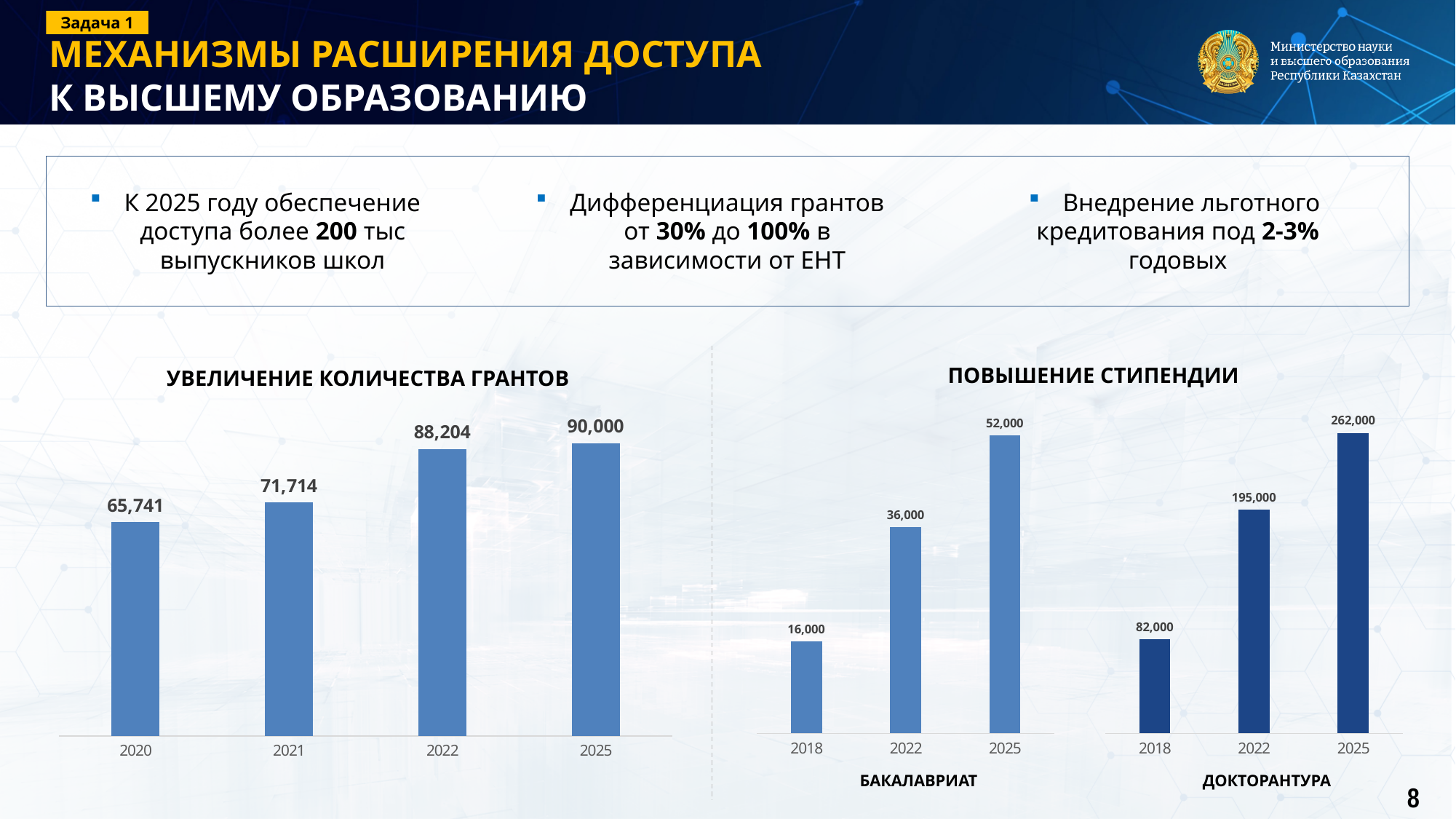
In the 'ПОВЫШЕНИЕ СТИПЕНДИИ' chart, what is the difference between the БАКАЛАВРИАТ values for 2025 and 2018? 36,000 In the chart titled 'УВЕЛИЧЕНИЕ КОЛИЧЕСТВА ГРАНТОВ', which year has the lowest value? 2020 In the chart titled 'УВЕЛИЧЕНИЕ КОЛИЧЕСТВА ГРАНТОВ', what is the value for 2021? 71,714 In the 'ПОВЫШЕНИЕ СТИПЕНДИИ' chart, which is larger: the ДОКТОРАНТУРА value for 2022 or the БАКАЛАВРИАТ value for 2025? ДОКТОРАНТУРА 2022 In the chart titled 'УВЕЛИЧЕНИЕ КОЛИЧЕСТВА ГРАНТОВ', do the values rise or fall from 2020 to 2025? rise What kind of chart is the one titled 'УВЕЛИЧЕНИЕ КОЛИЧЕСТВА ГРАНТОВ'? bar chart In the 'ПОВЫШЕНИЕ СТИПЕНДИИ' chart, what are the two groups labelled below the bars? БАКАЛАВРИАТ and ДОКТОРАНТУРА In the 'ПОВЫШЕНИЕ СТИПЕНДИИ' chart, which year has the highest ДОКТОРАНТУРА value? 2025 In the chart titled 'УВЕЛИЧЕНИЕ КОЛИЧЕСТВА ГРАНТОВ', what is the difference between the 2025 and 2020 values? 24,259 In the 'ПОВЫШЕНИЕ СТИПЕНДИИ' chart, what is the ДОКТОРАНТУРА value for 2018? 82,000 In the 'ПОВЫШЕНИЕ СТИПЕНДИИ' chart, what is the БАКАЛАВРИАТ value for 2022? 36,000 In the chart titled 'УВЕЛИЧЕНИЕ КОЛИЧЕСТВА ГРАНТОВ', how many years are shown? 4